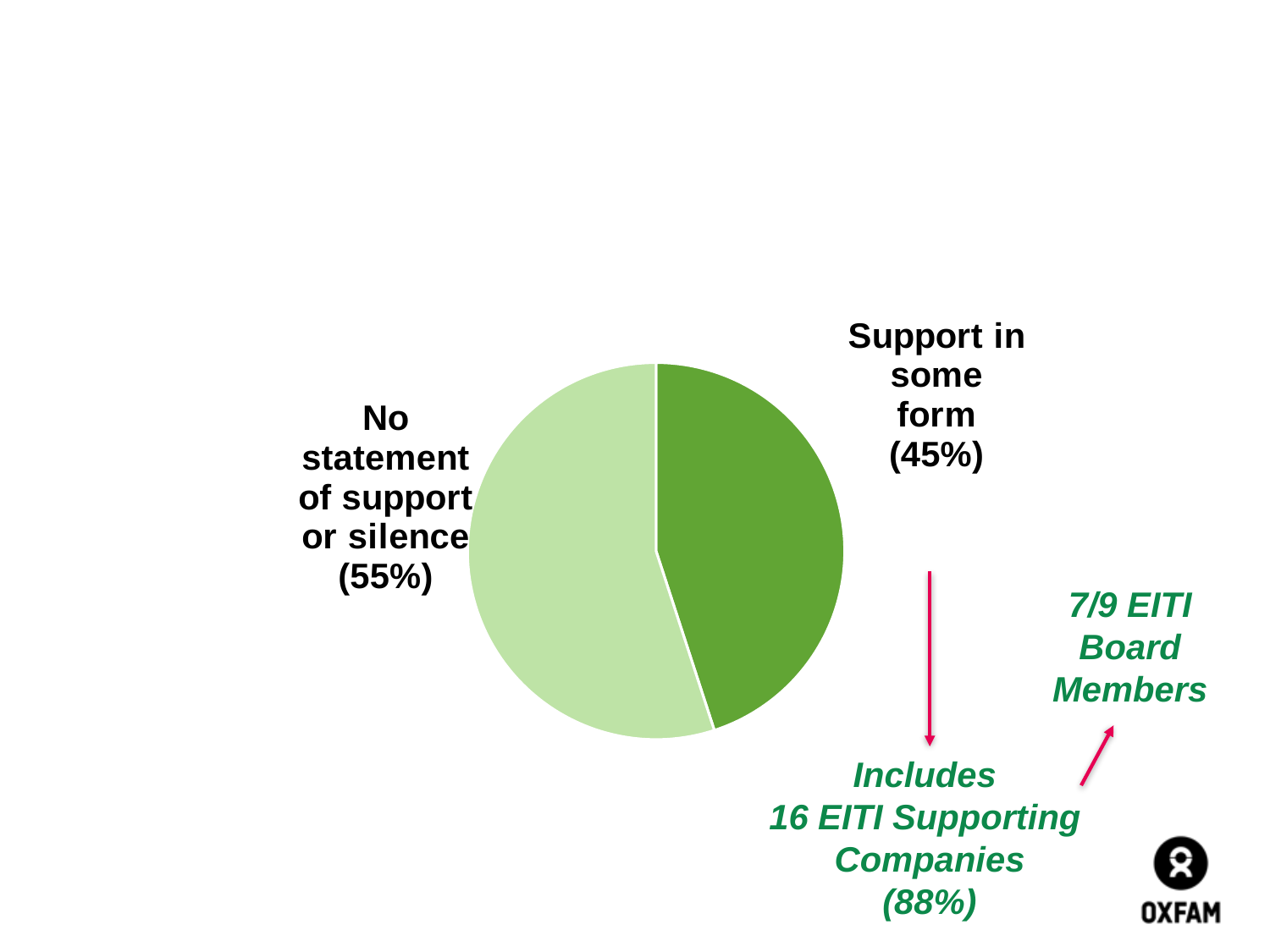
Which slice of the pie is the smallest? Support in some form What is the difference in percentage points between the "No statement of support or silence" slice and the "Support in some form" slice? 10 percentage points What share of the pie is labelled "Support in some form"? 45% Which slice of the pie is the largest? No statement of support or silence What do the two slices of the pie add up to? 100% According to the annotation, how many EITI Supporting Companies are included in the "Support in some form" slice? 16 Which is larger: the "Support in some form" slice or the "No statement of support or silence" slice? No statement of support or silence Which slice is shown in the darker green colour? Support in some form How many slices does the pie chart have? 2 What kind of chart is shown on the slide? pie chart What share of the pie is labelled "No statement of support or silence"? 55% Is the share for "Support in some form" greater or less than 50%? less